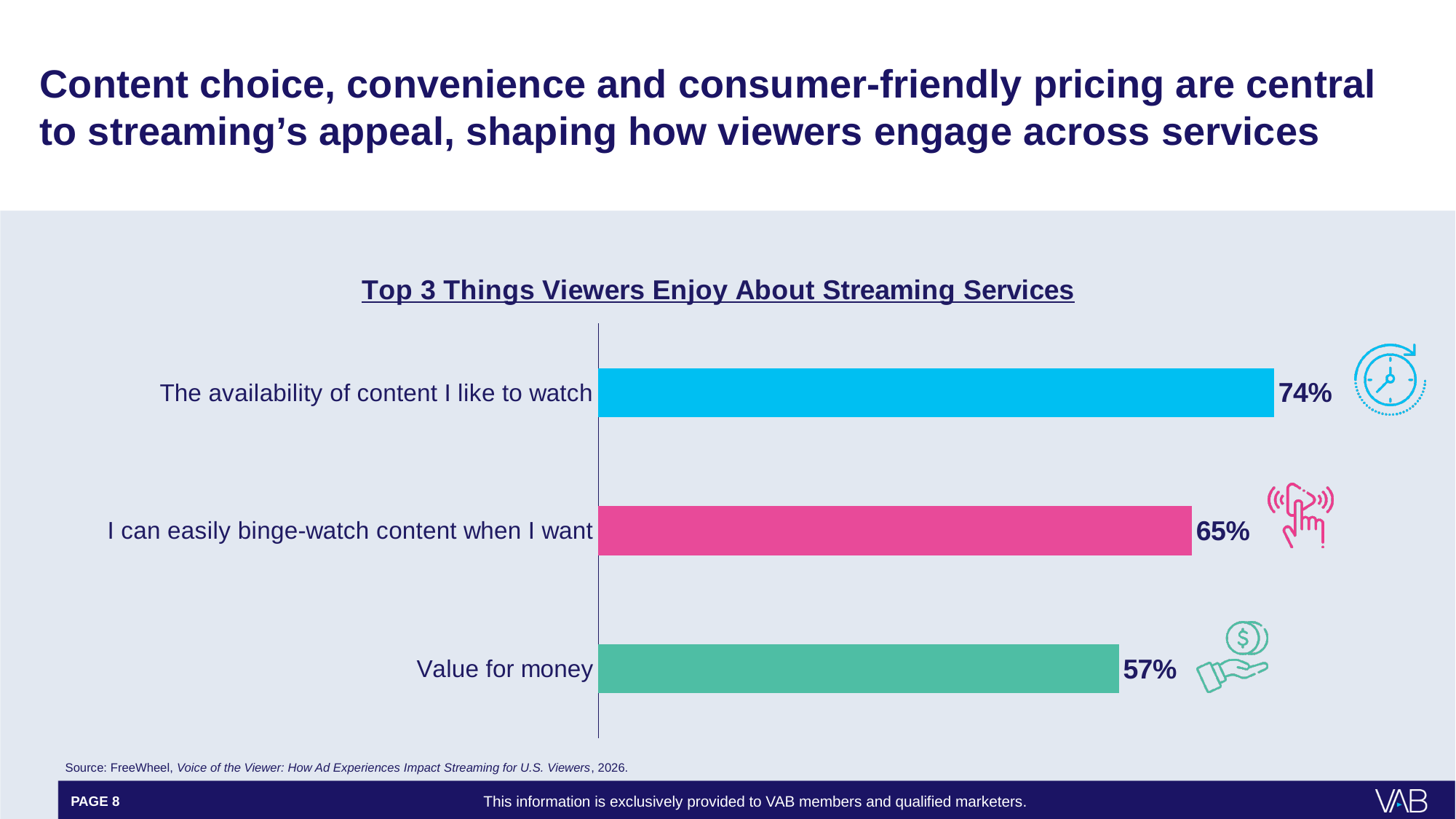
What is the difference between the values for 'The availability of content I like to watch' and 'Value for money'? 17% What is the title of the chart? Top 3 Things Viewers Enjoy About Streaming Services What percentage of viewers cited 'The availability of content I like to watch' as something they enjoy about streaming services? 74% What is the value for 'Value for money'? 57% What kind of chart is shown on the slide? Bar chart What is the value for 'I can easily binge-watch content when I want'? 65% Which category has the lowest value in the chart? Value for money What colour is the bar for 'Value for money'? Green Which is larger: the value for 'I can easily binge-watch content when I want' or the value for 'Value for money'? I can easily binge-watch content when I want Which category has the highest value in the chart? The availability of content I like to watch How many categories are shown in the chart? 3 What is the difference between the values for 'I can easily binge-watch content when I want' and 'Value for money'? 8%